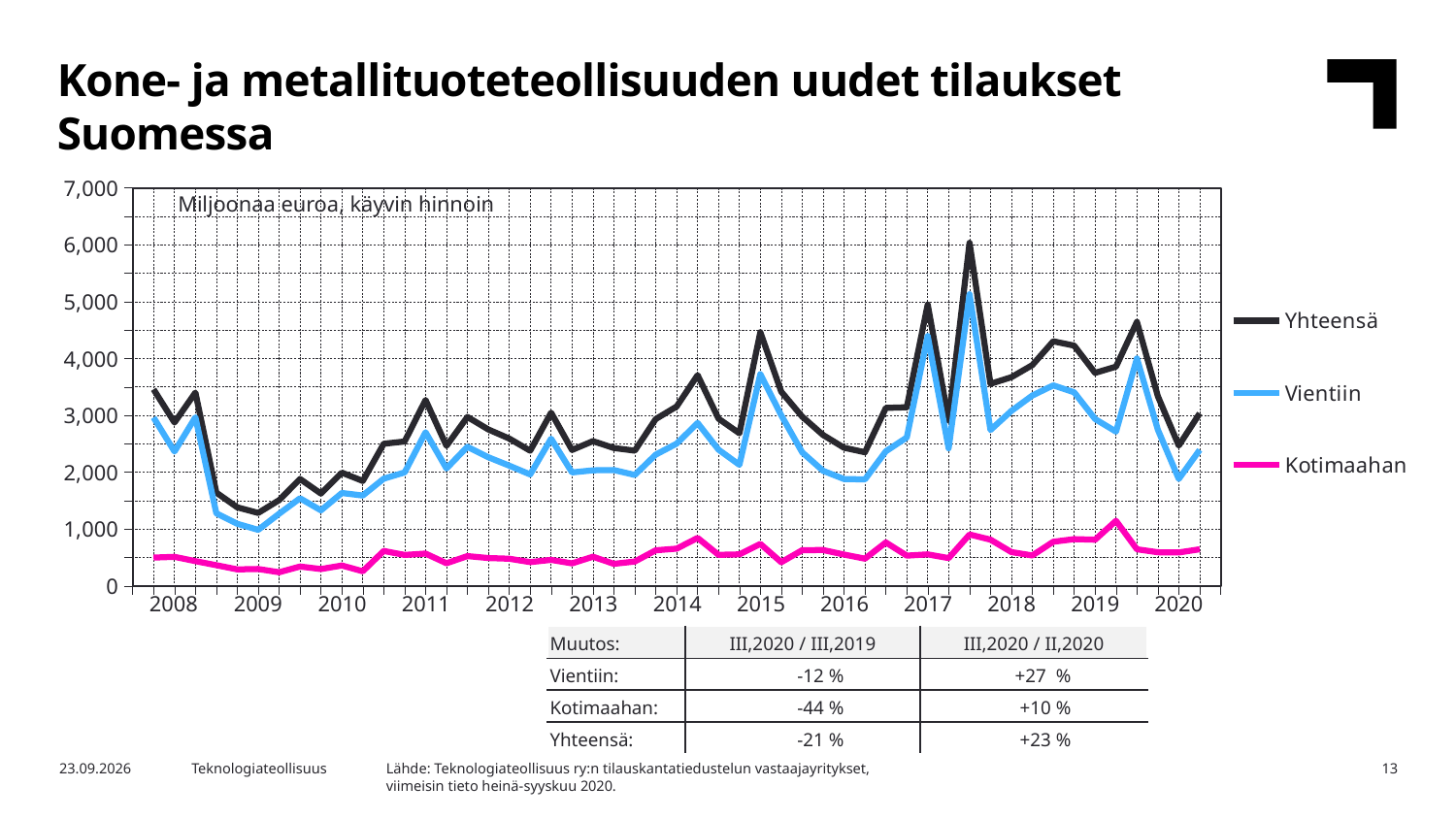
Which series is higher in 2015, Vientiin or Kotimaahan? Vientiin What is the title of the chart on the slide? Kone- ja metallituoteteollisuuden uudet tilaukset Suomessa Is the highest peak of the Yhteensä series greater or less than 5,000? greater In which year does the Yhteensä series reach its highest peak? 2017 How many series does the chart legend list? 3 How many year labels are shown on the x axis? 13 Does the Yhteensä series rise or fall from 2008 to 2009? fall Is the Kotimaahan value in 2008 greater or less than 1,000? less Which series has the lowest values throughout the chart? Kotimaahan Which series has the highest values throughout the chart? Yhteensä What kind of chart is shown on the slide? line chart What unit label is printed inside the chart area? Miljoonaa euroa, käyvin hinnoin